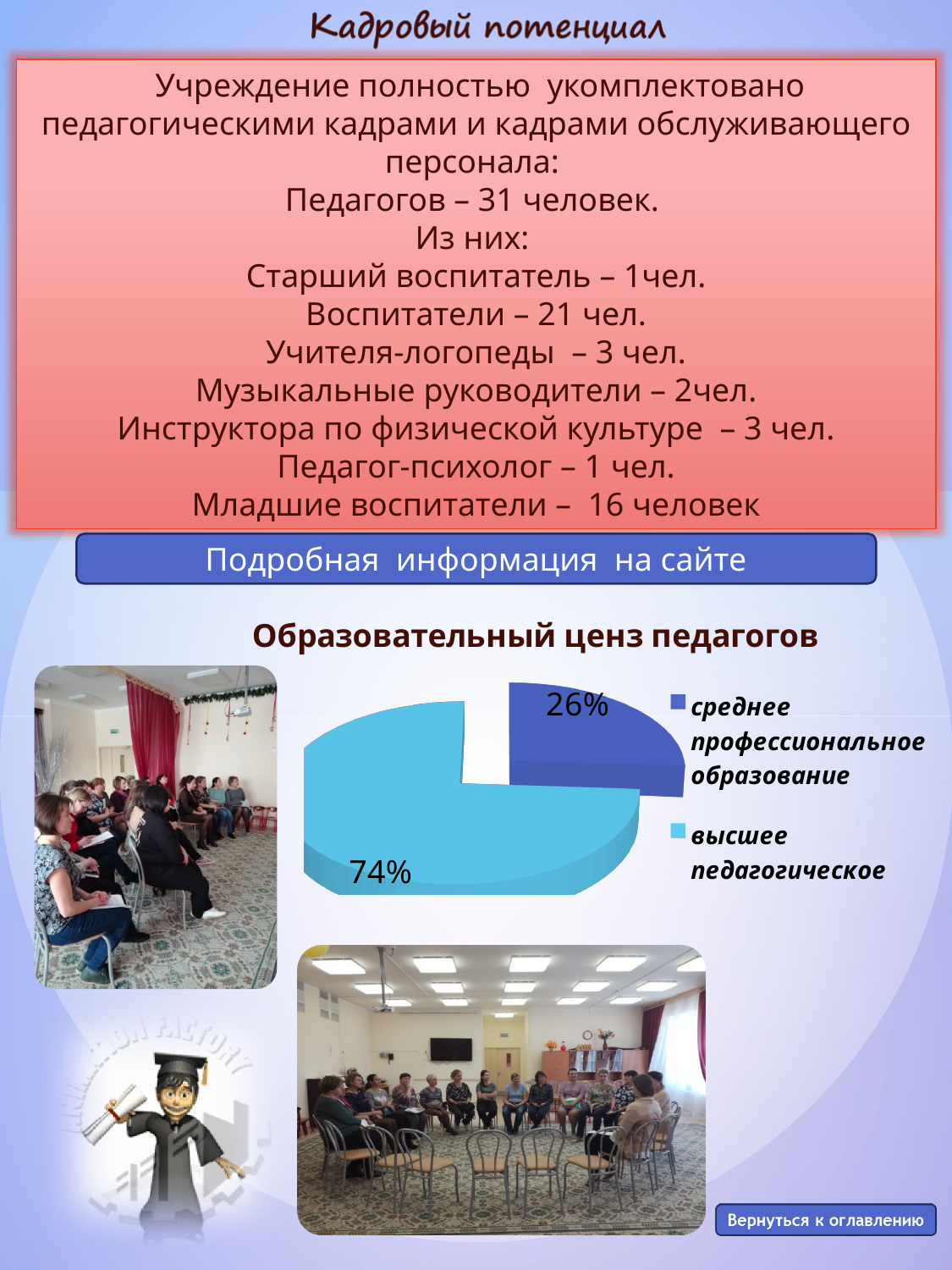
What share of the pie chart is labelled "среднее профессиональное образование"? 26% What type of chart is shown under the heading "Образовательный ценз педагогов"? pie chart Which category has the largest slice in the pie chart? высшее педагогическое How many entries does the legend of the pie chart list? 2 What is the title of the pie chart? Образовательный ценз педагогов How many slices does the pie chart have? 2 What colour is the "высшее педагогическое" slice in the pie chart? light blue Which category has the smallest slice in the pie chart? среднее профессиональное образование What share of the pie chart is labelled "высшее педагогическое"? 74% Which slice is larger: "высшее педагогическое" or "среднее профессиональное образование"? высшее педагогическое What is the difference in percentage points between the "высшее педагогическое" slice and the "среднее профессиональное образование" slice? 48 Is the share for "среднее профессиональное образование" greater or less than 50%? less